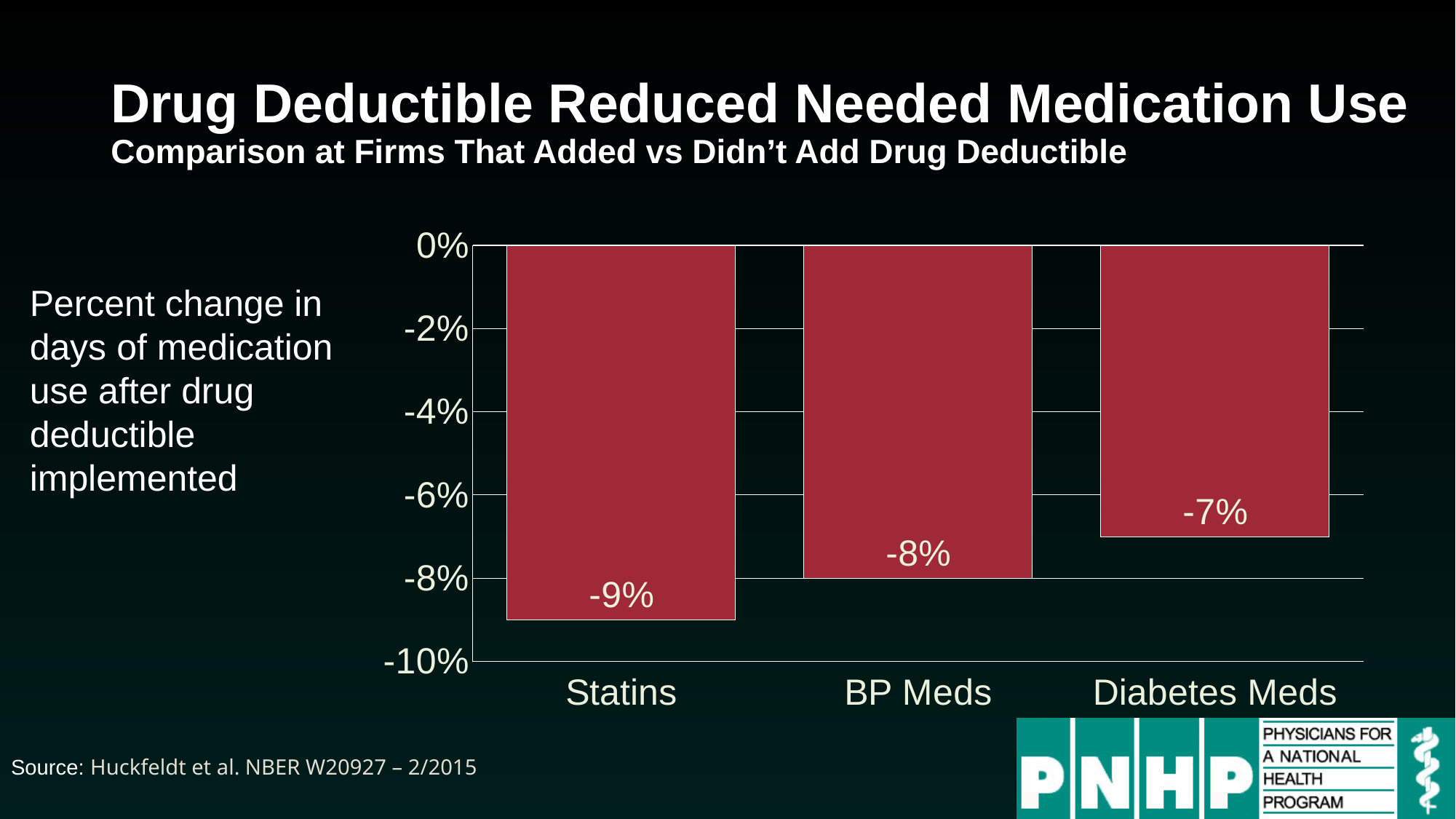
Which medication category shows the largest decline in days of medication use? Statins What type of chart is shown on the slide? Bar chart Which category had a larger decline in medication use, BP Meds or Diabetes Meds? BP Meds What is the difference in percentage points between the change for Statins and the change for Diabetes Meds? 2 percentage points Which medication category shows the smallest decline in days of medication use? Diabetes Meds What is the lowest value shown on the vertical axis? -10% How many medication categories are shown in the chart? 3 What is the percent change in days of medication use for BP Meds? -8% Do the bars become shorter or longer moving from Statins to Diabetes Meds along the x axis? Shorter What is the percent change in days of medication use for Diabetes Meds? -7% What is the percent change in days of medication use for Statins? -9% What is the title of the slide containing the chart? Drug Deductible Reduced Needed Medication Use